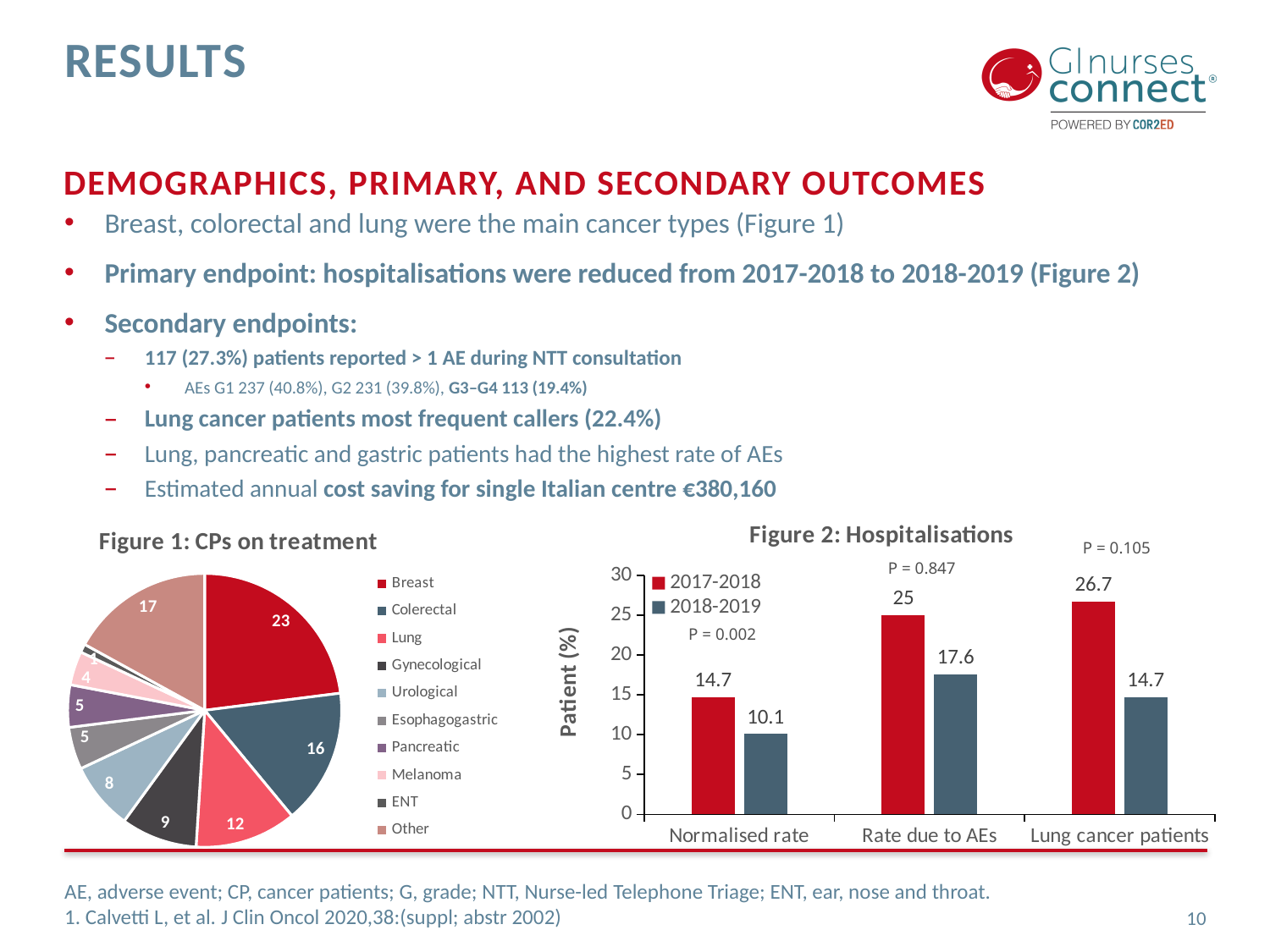
In Figure 2: Hospitalisations, how many series does the legend list? 2 In Figure 1: CPs on treatment, which cancer type has the largest slice? Breast In Figure 1: CPs on treatment, how many categories does the legend list? 10 In Figure 1: CPs on treatment, what is the difference between the Colorectal and Urological values? 8 In Figure 2: Hospitalisations, what is the difference between the 2017-2018 and 2018-2019 values for Normalised rate? 4.6 In Figure 1: CPs on treatment, what is the value for Breast? 23 In Figure 2: Hospitalisations, what kind of chart is shown? Bar chart In Figure 2: Hospitalisations, what is the 2018-2019 value for Rate due to AEs? 17.6 In Figure 1: CPs on treatment, what is the value for Lung? 12 In Figure 2: Hospitalisations, what is the 2017-2018 value for Lung cancer patients? 26.7 In Figure 1: CPs on treatment, what kind of chart is shown? Pie chart In Figure 2: Hospitalisations, which is larger for Lung cancer patients, the 2017-2018 value or the 2018-2019 value? 2017-2018